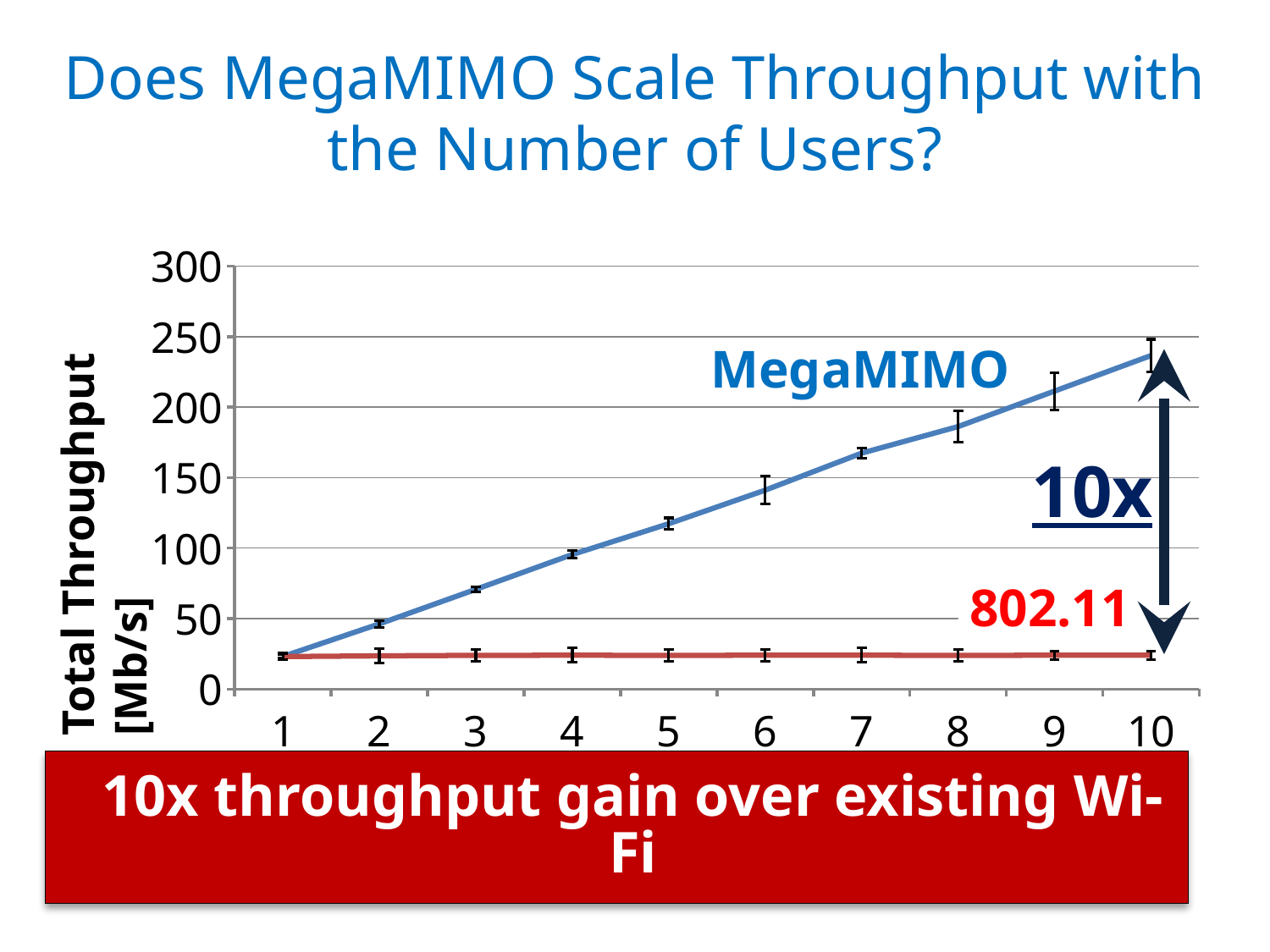
How many series are plotted on the chart? 2 At 10 users, which series has the higher total throughput, MegaMIMO or 802.11? MegaMIMO How many points along the x axis does each line have? 10 Is the MegaMIMO throughput at 7 users greater or less than 150 Mb/s? greater What is the label of the y axis? Total Throughput [Mb/s] Is the 802.11 throughput at 10 users greater or less than 50 Mb/s? less At which number of users is the MegaMIMO throughput lowest? 1 Does the MegaMIMO line rise or fall as the number of users increases from 1 to 10? rises Is the MegaMIMO throughput at 10 users greater or less than 200 Mb/s? greater What kind of chart is shown on the slide? line chart Does the 802.11 line rise, fall, or stay roughly flat as the number of users increases? stays roughly flat At which number of users does the MegaMIMO line reach its highest value? 10